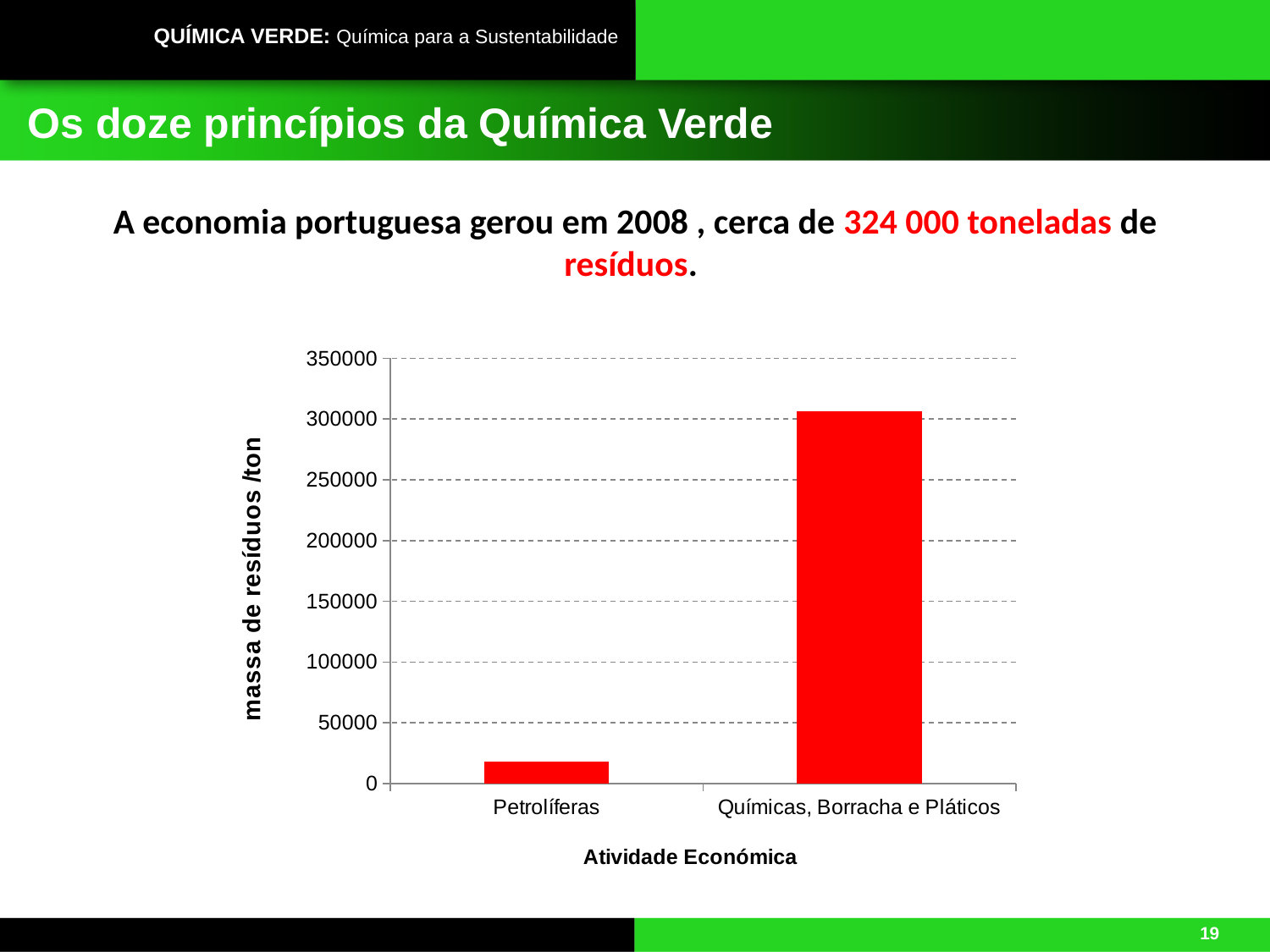
Is the value for Petrolíferas greater or less than 50000? less What is the highest tick value shown on the y axis of the chart? 350000 Which category has the lowest value in the chart? Petrolíferas What is the label of the y axis of the chart? massa de resíduos /ton Is the value for Químicas, Borracha e Pláticos greater or less than 350000? less Which category has the highest value in the chart? Químicas, Borracha e Pláticos What kind of chart is shown on the slide? bar chart Is the value for Químicas, Borracha e Pláticos greater or less than 300000? greater How many categories are shown on the x axis of the chart? 2 What is the label of the x axis of the chart? Atividade Económica Which is larger, the value for Petrolíferas or the value for Químicas, Borracha e Pláticos? Químicas, Borracha e Pláticos